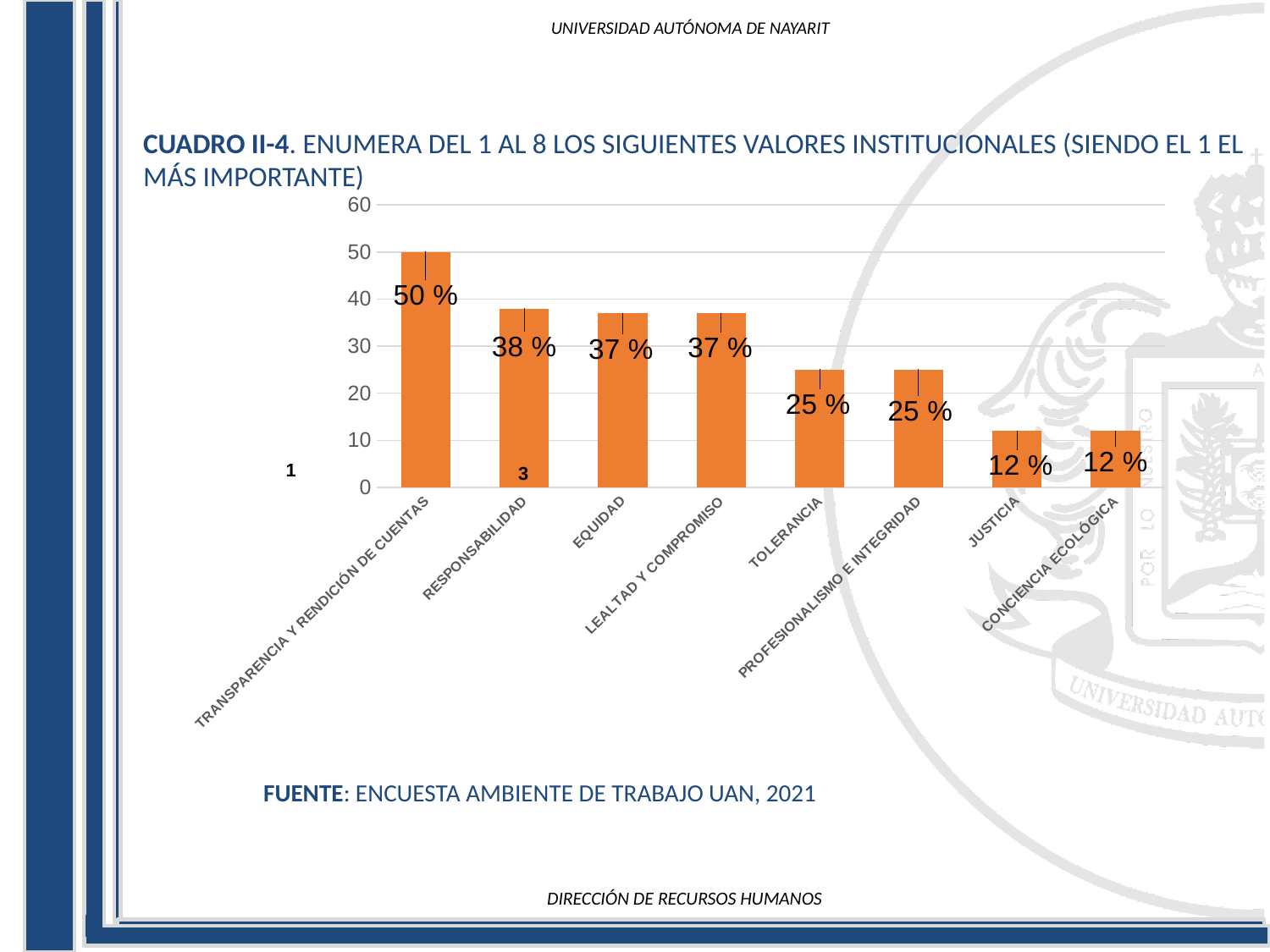
What is the value for JUSTICIA? 12 % Is the value for PROFESIONALISMO E INTEGRIDAD greater or less than 30? less What kind of chart is shown on the slide? bar chart Which category has the highest value? TRANSPARENCIA Y RENDICIÓN DE CUENTAS What is the value for TRANSPARENCIA Y RENDICIÓN DE CUENTAS? 50 % Which is larger, the value for RESPONSABILIDAD or the value for TOLERANCIA? RESPONSABILIDAD What is the value for TOLERANCIA? 25 % What colour are the bars in the chart? orange What is the difference between the values for TRANSPARENCIA Y RENDICIÓN DE CUENTAS and RESPONSABILIDAD? 12 % What is the value for RESPONSABILIDAD? 38 % Do the values rise or fall from left to right along the x axis? fall How many categories are shown in the chart? 8